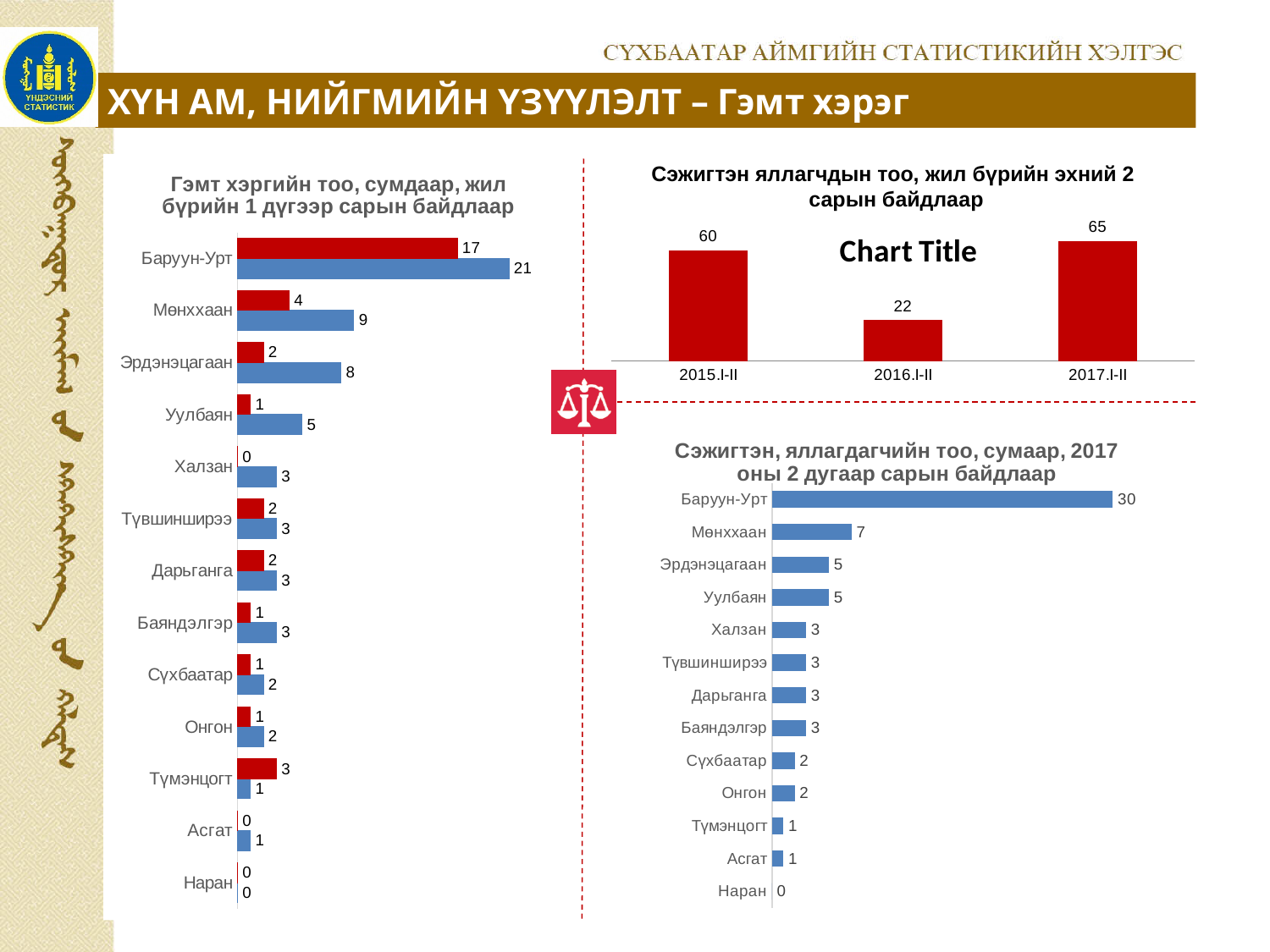
What kind of chart is the bottom-right chart 'Сэжигтэн, яллагдагчийн тоо, сумаар, 2017 оны 2 дугаар сарын байдлаар'? Bar chart In the top-right chart 'Сэжигтэн яллагчдын тоо, жил бүрийн эхний 2 сарын байдлаар', what is the difference between the values for 2017.I-II and 2015.I-II? 5 In the left chart 'Гэмт хэргийн тоо, сумдаар, жил бүрийн 1 дүгээр сарын байдлаар', what is the difference between the blue and red bars for Мөнххаан? 5 In the top-right chart 'Сэжигтэн яллагчдын тоо, жил бүрийн эхний 2 сарын байдлаар', which period has the highest value? 2017.I-II How many periods are shown in the top-right chart 'Сэжигтэн яллагчдын тоо, жил бүрийн эхний 2 сарын байдлаар'? 3 In the bottom-right chart 'Сэжигтэн, яллагдагчийн тоо, сумаар, 2017 оны 2 дугаар сарын байдлаар', which category has the highest value? Баруун-Урт In the bottom-right chart 'Сэжигтэн, яллагдагчийн тоо, сумаар, 2017 оны 2 дугаар сарын байдлаар', which category has the lowest value? Наран How many categories are shown in the bottom-right chart 'Сэжигтэн, яллагдагчийн тоо, сумаар, 2017 оны 2 дугаар сарын байдлаар'? 13 In the bottom-right chart 'Сэжигтэн, яллагдагчийн тоо, сумаар, 2017 оны 2 дугаар сарын байдлаар', what is the value for Мөнххаан? 7 In the top-right chart 'Сэжигтэн яллагчдын тоо, жил бүрийн эхний 2 сарын байдлаар', what is the value for 2016.I-II? 22 In the left chart 'Гэмт хэргийн тоо, сумдаар, жил бүрийн 1 дүгээр сарын байдлаар', what is the value of the blue bar for Баруун-Урт? 21 In the left chart 'Гэмт хэргийн тоо, сумдаар, жил бүрийн 1 дүгээр сарын байдлаар', which is larger for Түмэнцогт, the red bar or the blue bar? The red bar